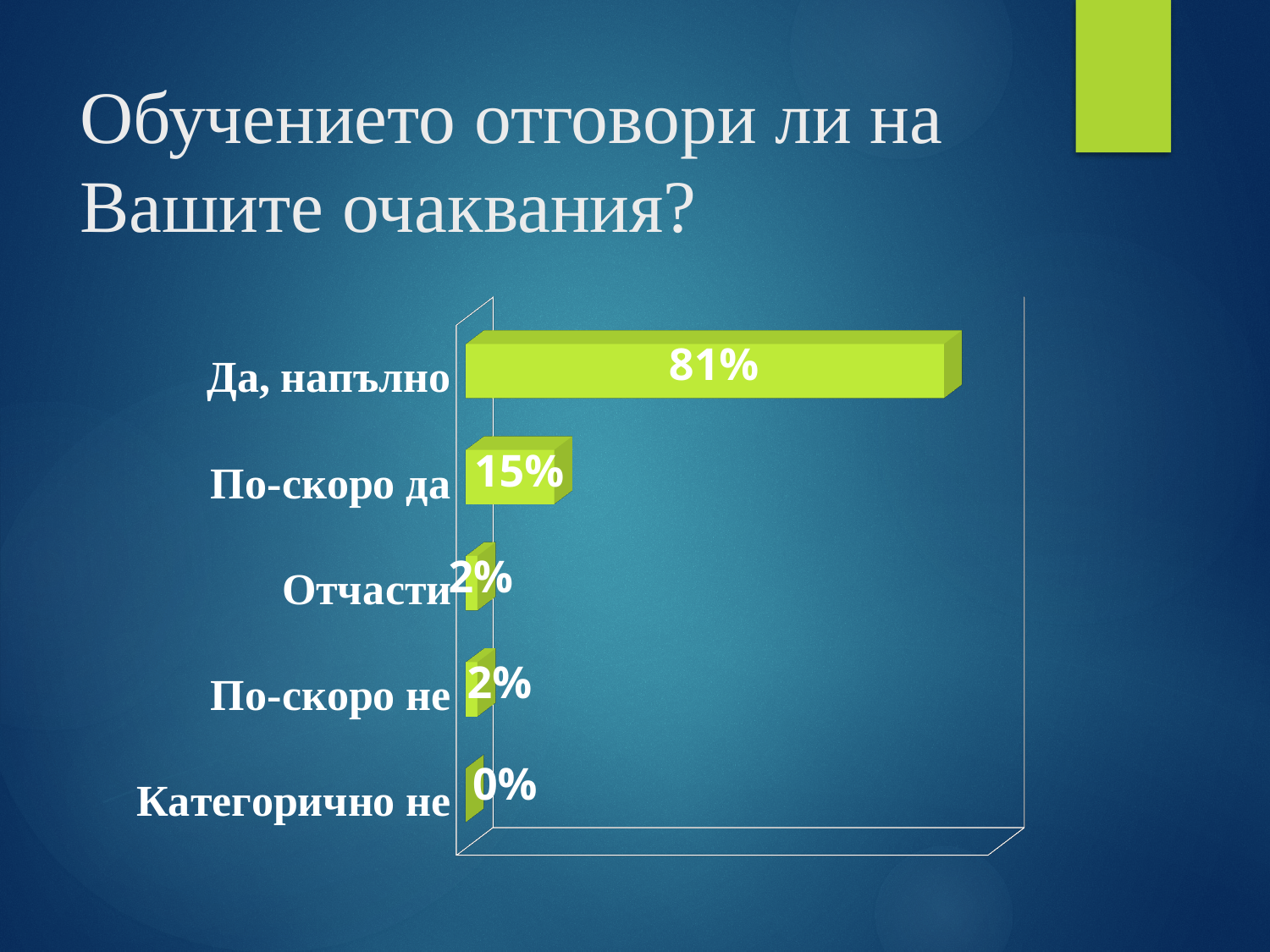
What value is shown for "Категорично не"? 0% What is the difference between the values for "Да, напълно" and "По-скоро да"? 66% What value is shown for "Да, напълно"? 81% What is the title of the slide containing the chart? Обучението отговори ли на Вашите очаквания? How many categories are shown in the chart? 5 What value is shown for "По-скоро да"? 15% Which category has the lowest value? Категорично не What value is shown for "Отчасти"? 2% What is the difference between the values for "По-скоро да" and "По-скоро не"? 13% What kind of chart is shown on the slide? Bar chart Which is larger, the value for "По-скоро да" or the value for "Отчасти"? По-скоро да Which category has the highest value? Да, напълно